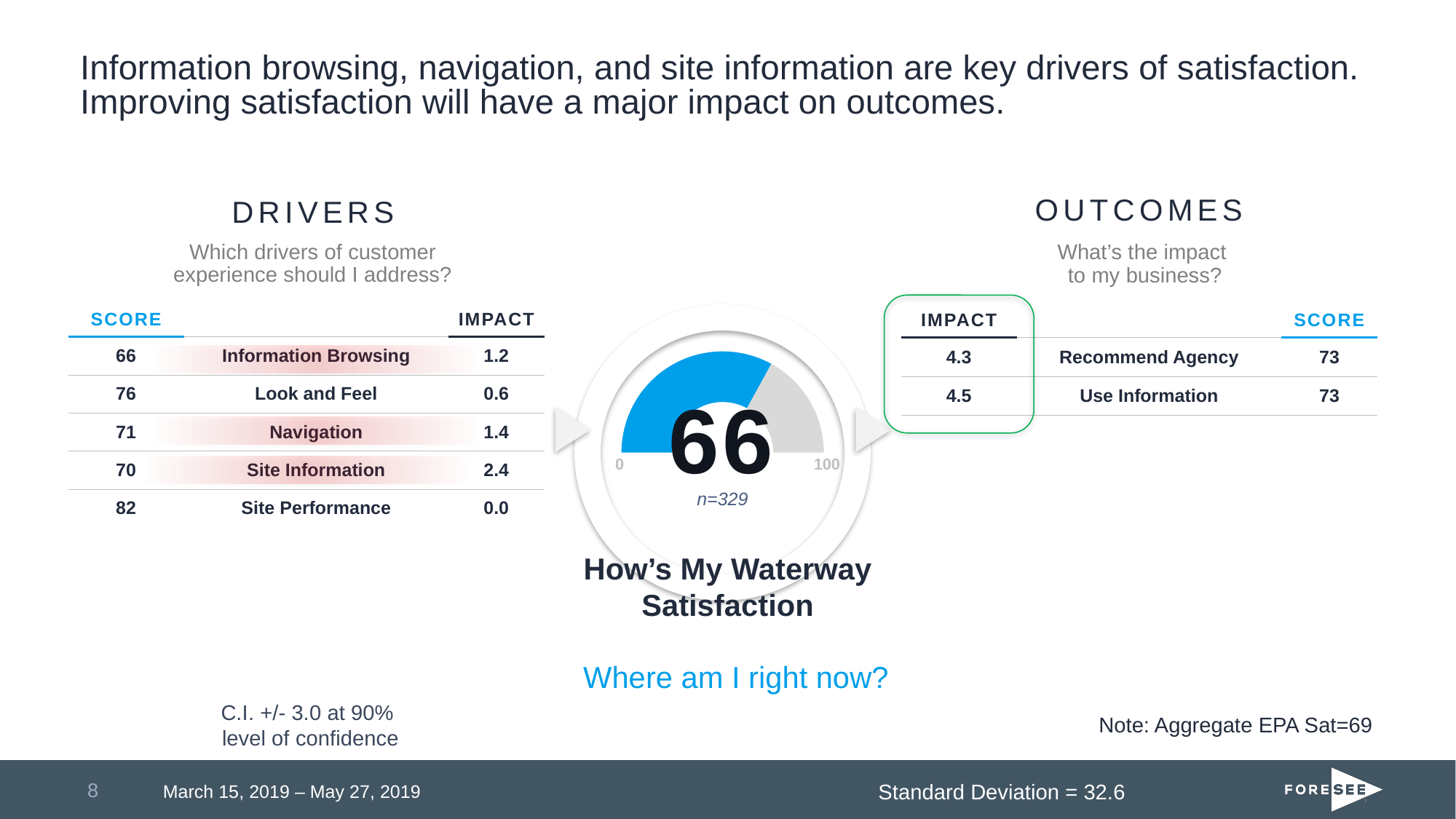
In the Drivers table, what is the score for Site Performance? 82 What is the maximum value shown on the gauge chart's scale? 100 What satisfaction score does the gauge chart show for How's My Waterway? 66 How many drivers are listed in the Drivers table? 5 In the Drivers table, which driver has the lowest score? Information Browsing In the Drivers table, what is the difference between the scores for Site Performance and Information Browsing? 16 What kind of chart is used to display the How's My Waterway Satisfaction score? gauge chart Is the satisfaction score on the gauge chart greater or less than 50? greater What is the minimum value shown on the gauge chart's scale? 0 In the Drivers table, which driver has the highest impact? Site Information In the Outcomes table, what is the impact value for Use Information? 4.5 What sample size (n) is shown beneath the gauge value? n=329